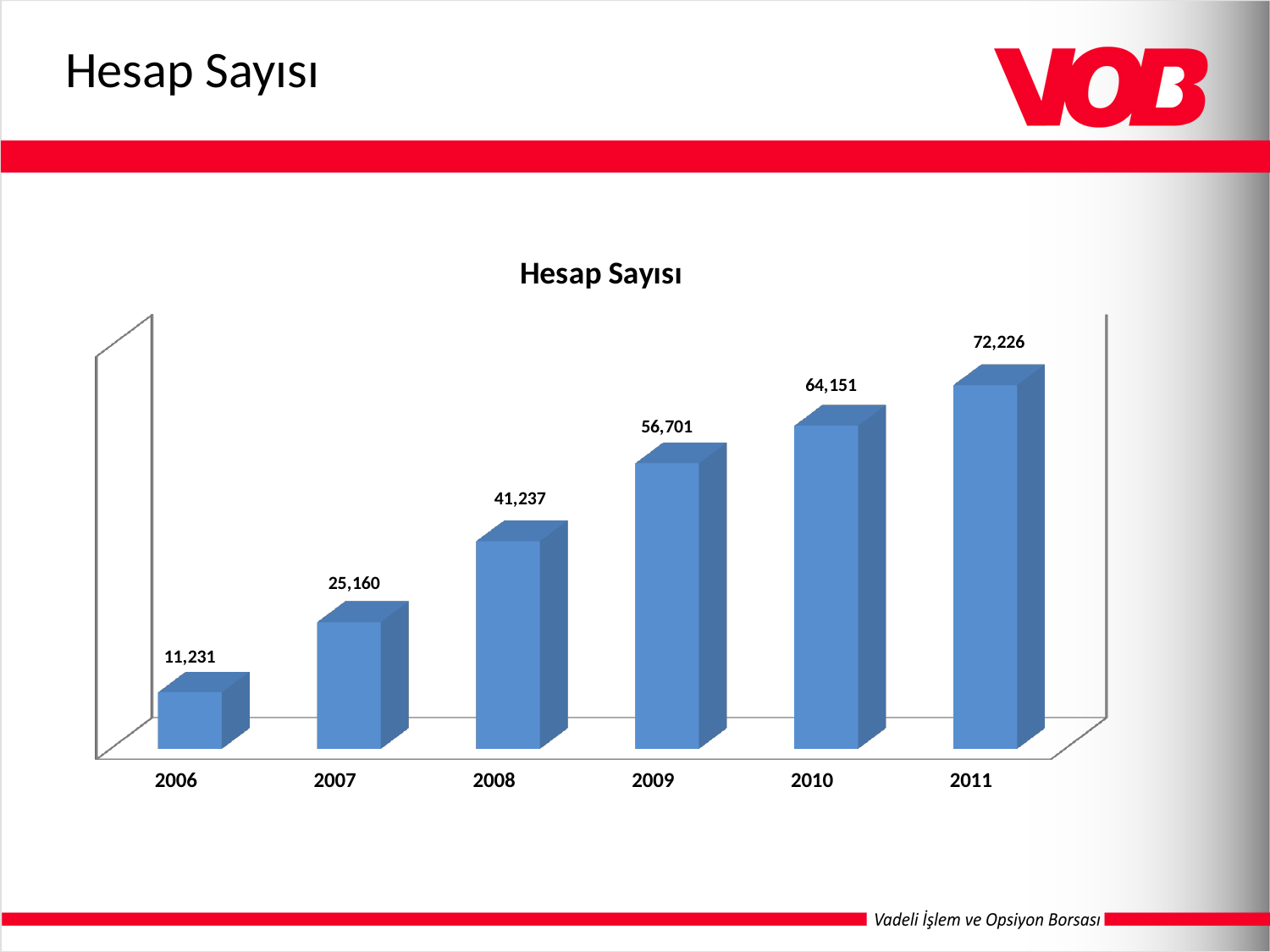
What kind of chart is this? bar chart Which year has the lowest value? 2006 What is the value for 2006? 11,231 What is the title of the chart? Hesap Sayısı How many years are shown on the x axis? 6 Which is larger, the value for 2007 or the value for 2009? 2009 Which year has the highest value? 2011 What is the difference between the values for 2011 and 2010? 8,075 What is the value for 2010? 64,151 Do the values rise or fall from 2006 to 2011? rise What is the difference between the values for 2009 and 2008? 15,464 What is the value for 2008? 41,237